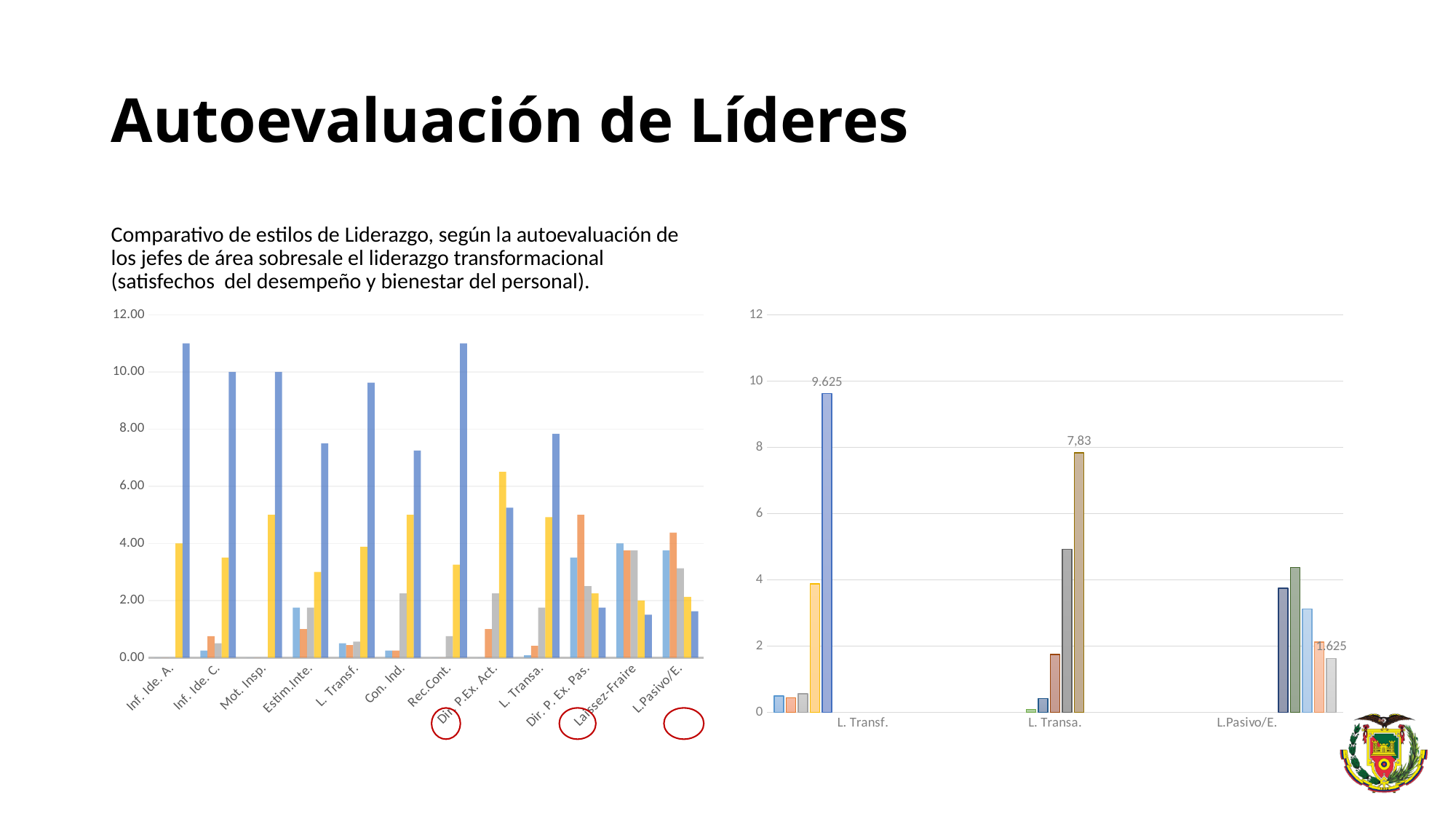
On the right chart, what is the difference between the labelled values for L. Transf. (9.625) and L.Pasivo/E. (1.625)? 8 On the right chart, how many categories are shown on the x axis? 3 On the right chart, which labelled value is larger: L. Transf. or L.Pasivo/E.? L. Transf. On the right chart, what is the labelled value for L. Transa.? 7,83 On the left chart, how many categories are shown on the x axis? 12 On the left chart, is the value of the tallest (blue) bar for Inf. Ide. A. greater or less than 10.00? greater On the right chart, which category has the highest labelled value? L. Transf. On the right chart, what is the labelled value for L.Pasivo/E.? 1.625 On the right chart, what is the labelled value for L. Transf.? 9.625 What kind of chart is the right chart? bar chart On the left chart, what is the highest value shown on the y axis? 12.00